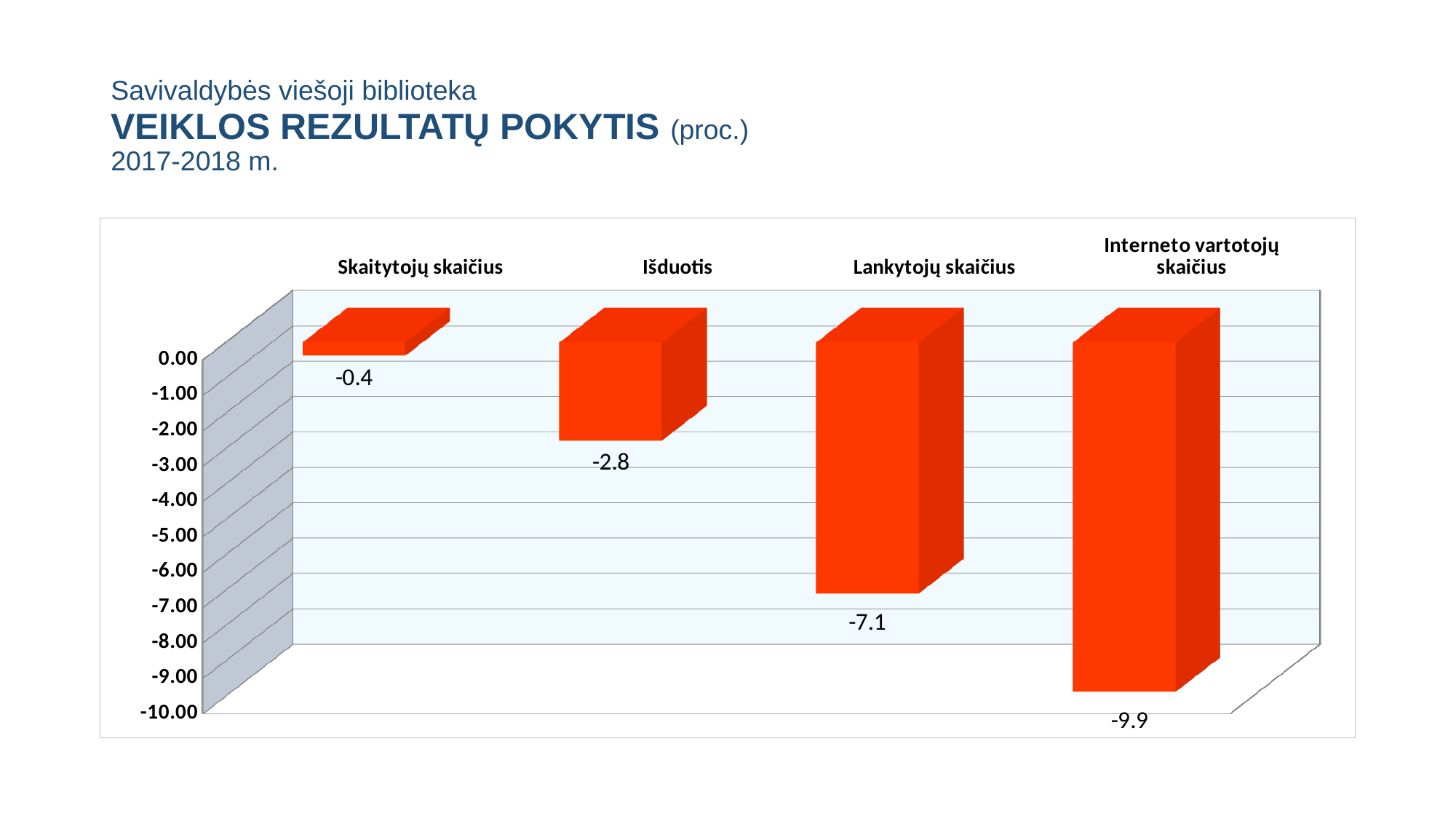
Do the values rise or fall from left to right across the categories? Fall Which is larger, the value for Išduotis or the value for Lankytojų skaičius? Išduotis What is the value for Išduotis? -2.8 What is the value for Skaitytojų skaičius? -0.4 What is the value for Interneto vartotojų skaičius? -9.9 Which category has the highest value? Skaitytojų skaičius Which category has the lowest value? Interneto vartotojų skaičius What is the value for Lankytojų skaičius? -7.1 What is the difference between the values for Interneto vartotojų skaičius and Skaitytojų skaičius? 9.5 What kind of chart is shown on the slide? Bar chart How many categories are shown in the chart? 4 What is the difference between the values for Lankytojų skaičius and Išduotis? 4.3